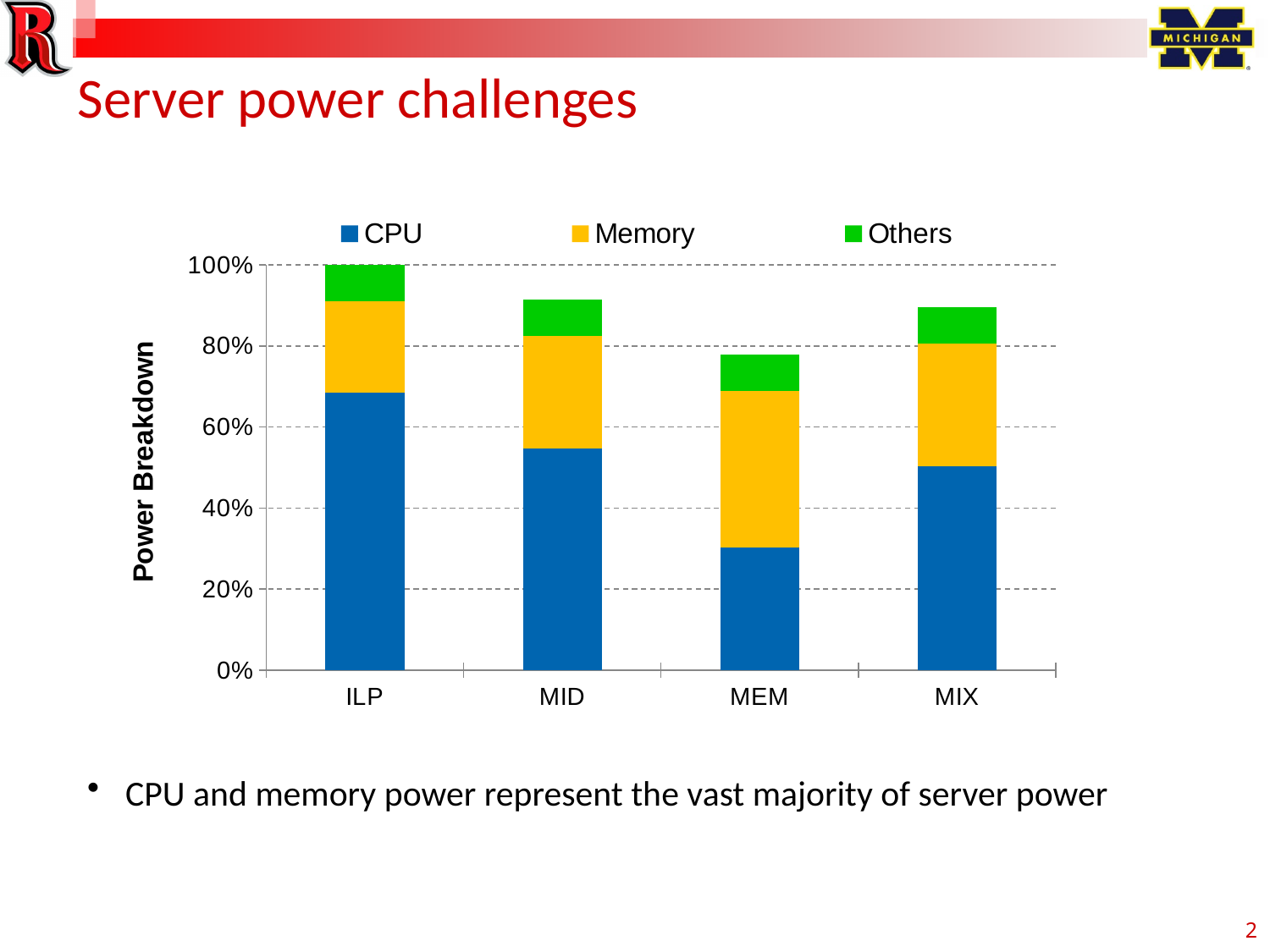
What kind of chart is shown on the slide? Stacked bar chart What is the title of the vertical axis of the chart? Power Breakdown Which category has a larger CPU share, ILP or MEM? ILP Is the CPU value for ILP greater or less than 60%? greater How many categories are shown on the x axis of the chart? 4 How many series does the chart's legend list? 3 Which category has the lowest CPU share in the chart? MEM Which category's stacked bar reaches the lowest total height? MEM Is the CPU value for MID greater or less than 60%? less What is the total height of the stacked bar for ILP? 100% Which category has the highest CPU share in the chart? ILP Is the CPU value for MEM greater or less than 40%? less